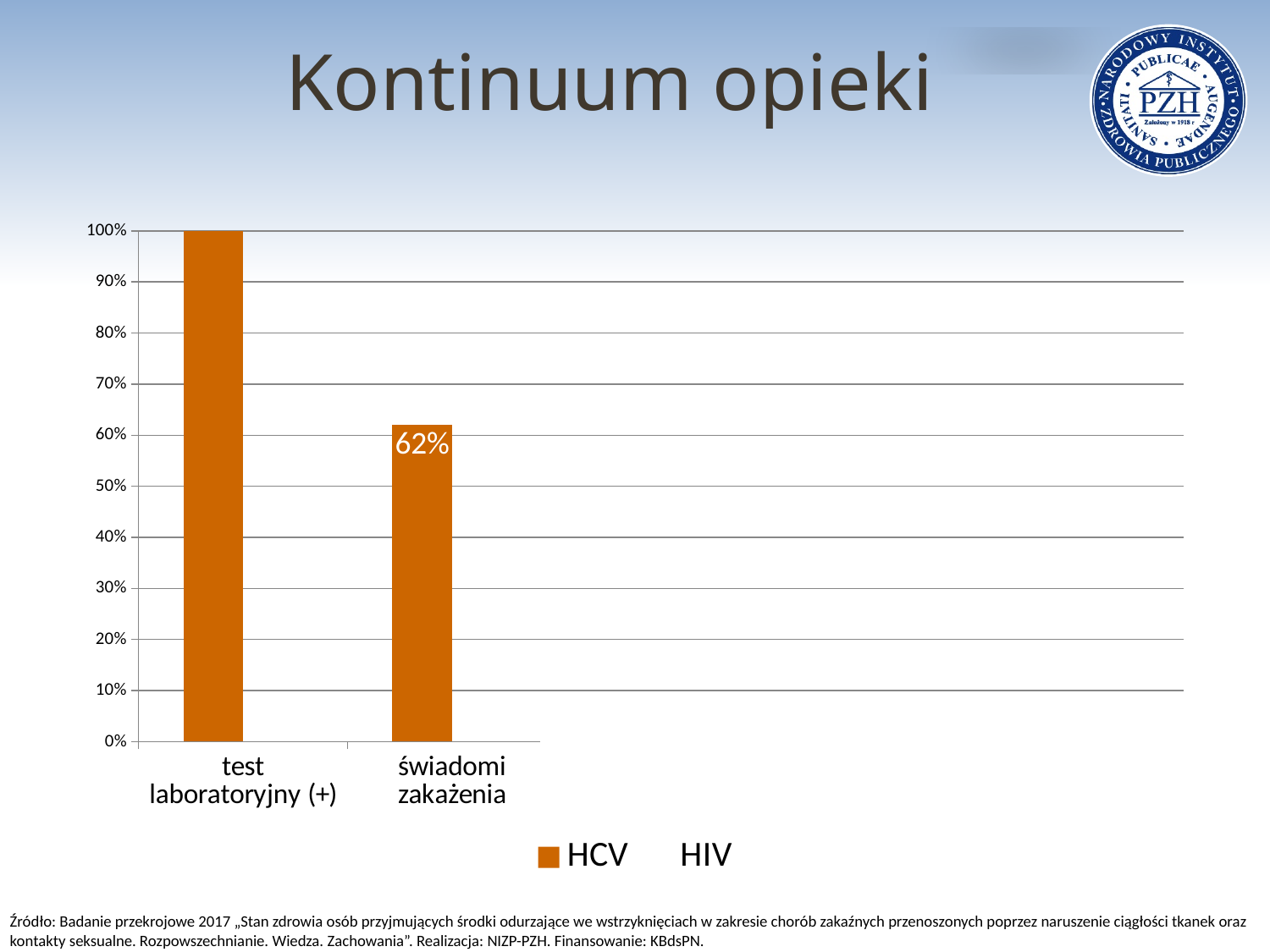
How many categories are shown on the x axis? 2 Which is larger, the HCV value for "test laboratoryjny (+)" or for "świadomi zakażenia"? test laboratoryjny (+) What kind of chart is shown on the slide? bar chart What is the HCV value for "świadomi zakażenia"? 62% Do the HCV values rise or fall from "test laboratoryjny (+)" to "świadomi zakażenia"? fall Is the HCV value for "świadomi zakażenia" greater or less than 50%? greater Which category has the highest HCV bar? test laboratoryjny (+) How many series does the legend list? 2 What is the difference between the HCV values for "test laboratoryjny (+)" and "świadomi zakażenia"? 38% Which category has the lowest HCV bar? świadomi zakażenia What is the title of the slide containing the chart? Kontinuum opieki What is the HCV value for "test laboratoryjny (+)"? 100%